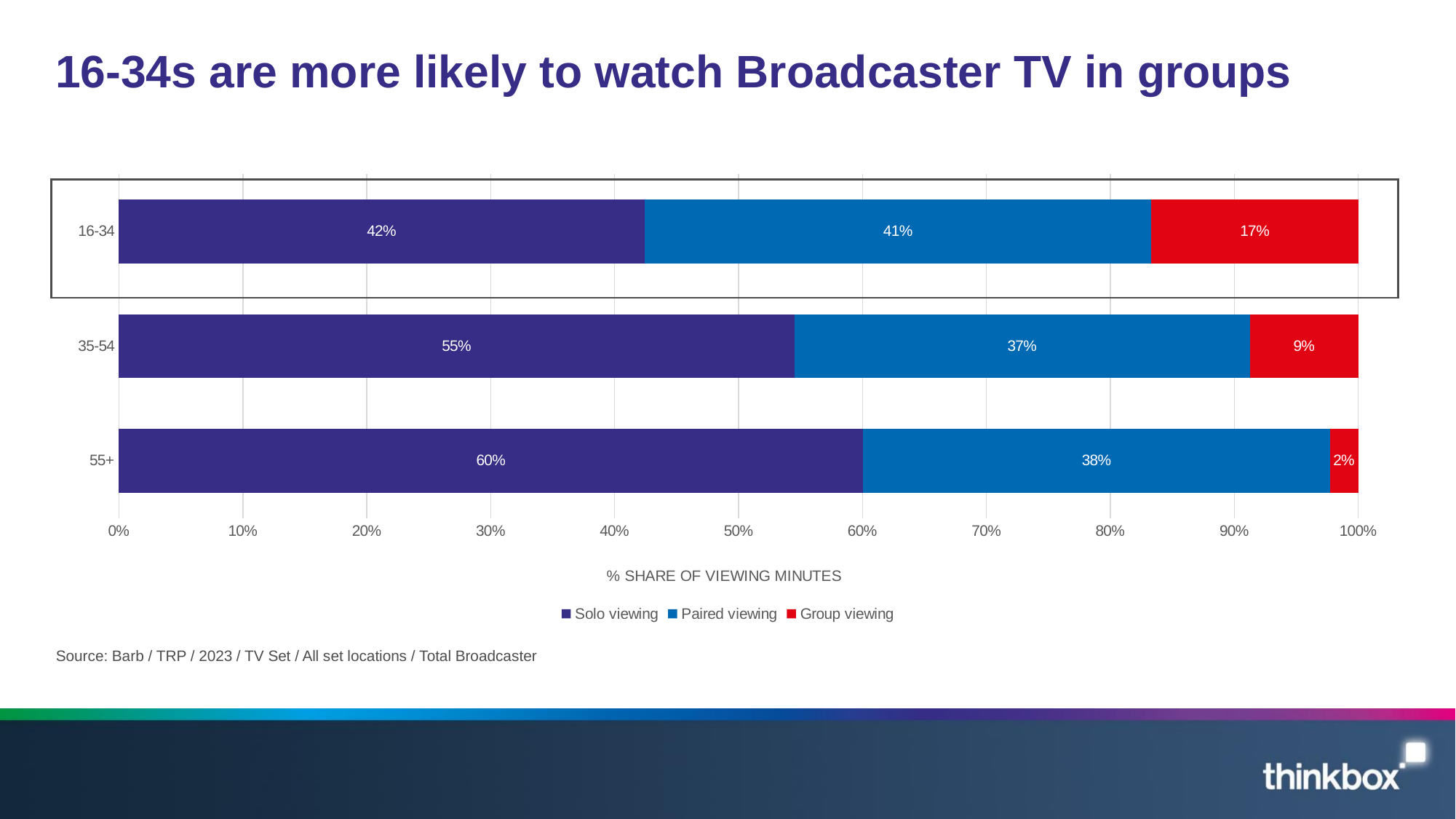
Which is larger: the Group viewing share for 35-54 or for 55+? 35-54 What is the label of the x axis? % SHARE OF VIEWING MINUTES What is the Paired viewing share for the 55+ age group? 38% How many age groups are shown on the chart? 3 Which age group has the lowest Solo viewing share? 16-34 What is the Solo viewing share for the 16-34 age group? 42% What is the total of the stacked bar for the 35-54 age group? 101% What kind of chart is shown on the slide? Stacked bar chart What is the difference between the Solo viewing share for 55+ and for 16-34? 18 percentage points Which age group has the highest Group viewing share? 16-34 How many series does the legend list? 3 What is the Group viewing share for the 35-54 age group? 9%